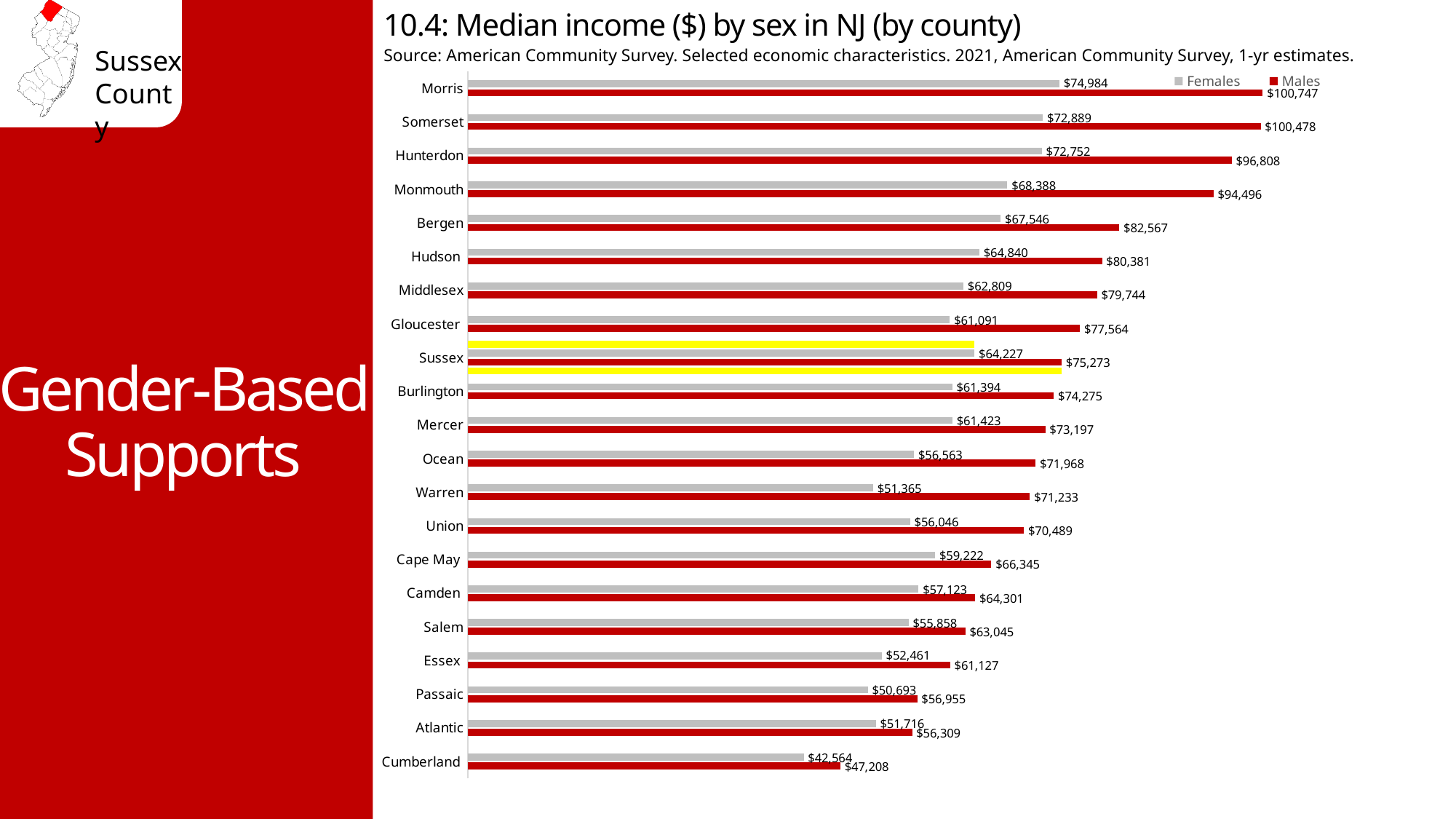
How many series does the legend list? 2 Which colour represents Males in the chart? Red What is the difference between the male and female median income in Sussex County? $11,046 What kind of chart is shown on the slide? Bar chart How many counties are shown in the chart? 21 Which county has the lowest median income for females? Cumberland What is the median income for males in Cumberland County? $47,208 What is the median income for females in Sussex County? $64,227 What is the median income for females in Warren County? $51,365 Which county has the highest median income for males? Morris What is the median income for males in Sussex County? $75,273 Which is larger, the female median income in Sussex or the female median income in Gloucester? Sussex